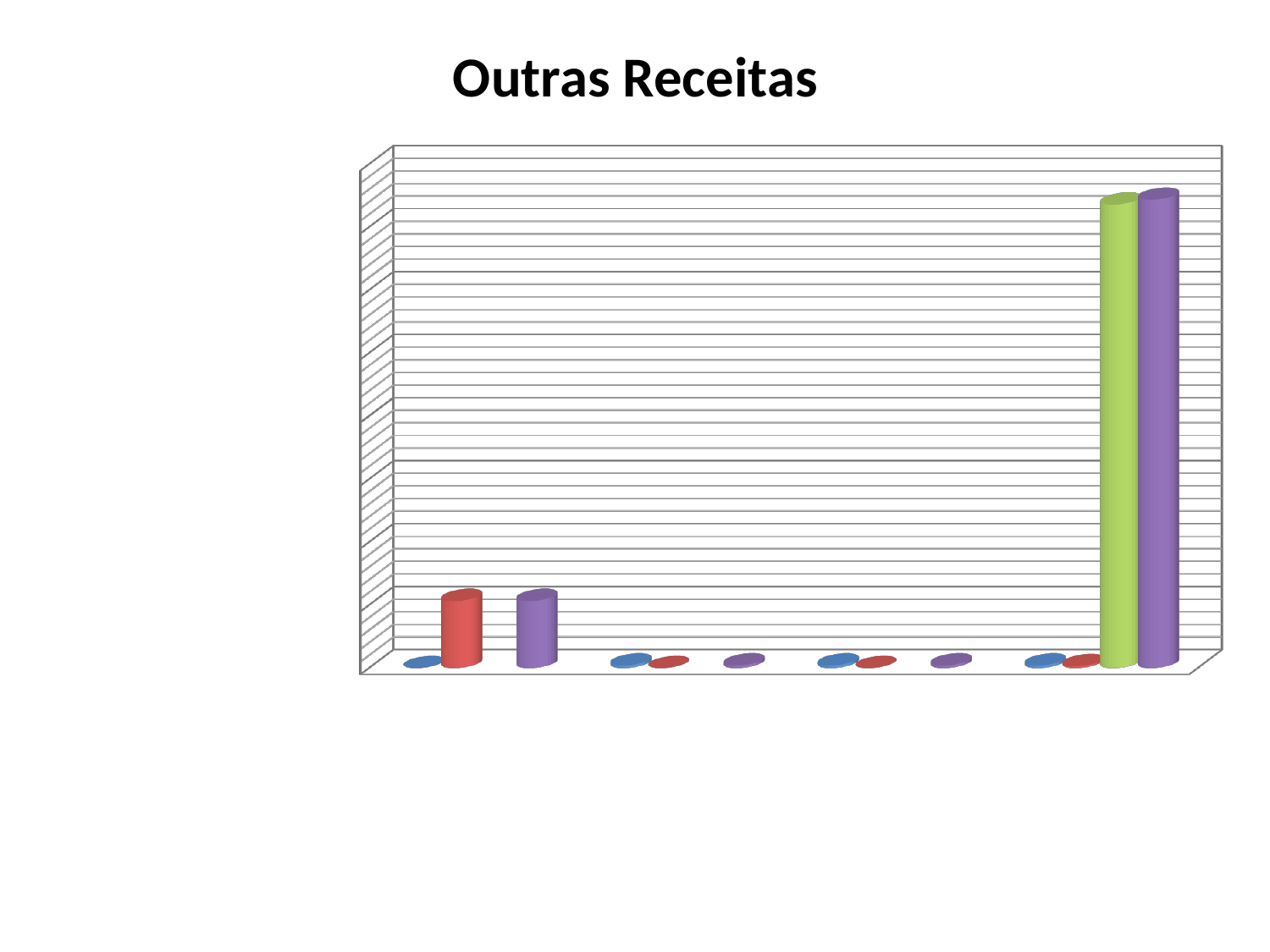
What kind of chart is shown on the slide? bar chart How many groups of bars are plotted along the x axis? 4 Which group of bars, counting from the left, contains the tallest bars? the fourth (rightmost) group How many different bar colours appear in the chart? 4 What is the title of the chart? Outras Receitas